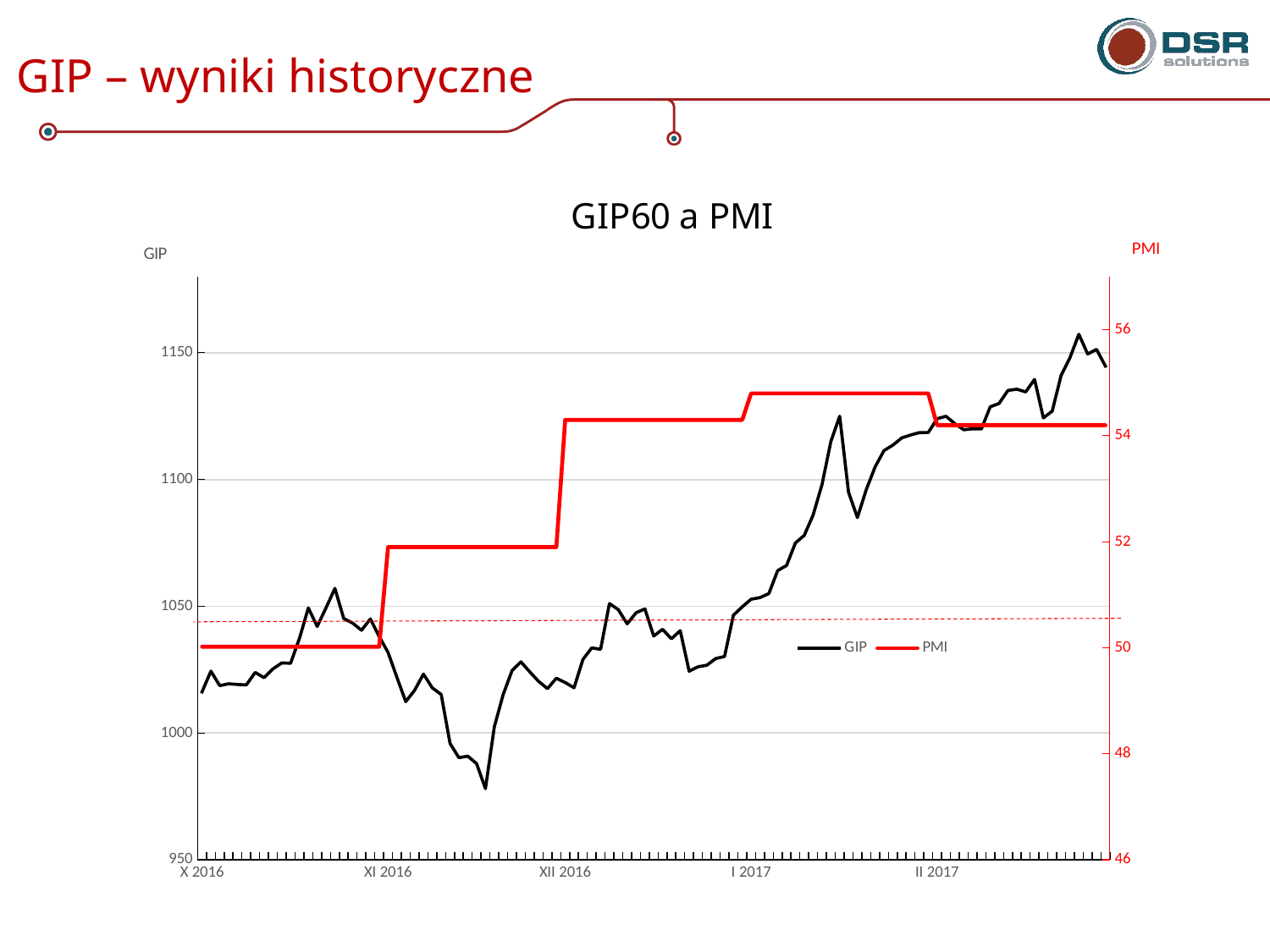
Is the value of PMI at II 2017 greater or less than 52? greater Is PMI higher at X 2016 or at I 2017? I 2017 What kind of chart is shown on the slide? line chart Is the value of PMI at X 2016 greater or less than 52? less Which series is drawn in red on the chart? PMI Is the value of GIP at X 2016 greater or less than 1050? less What is the title of the chart? GIP60 a PMI Does the PMI series generally rise or fall from X 2016 to II 2017? rise Does the GIP series overall rise or fall from the start of the chart to its end? rise How many month labels are shown on the x axis of the chart? 5 How many series does the legend of the chart list? 2